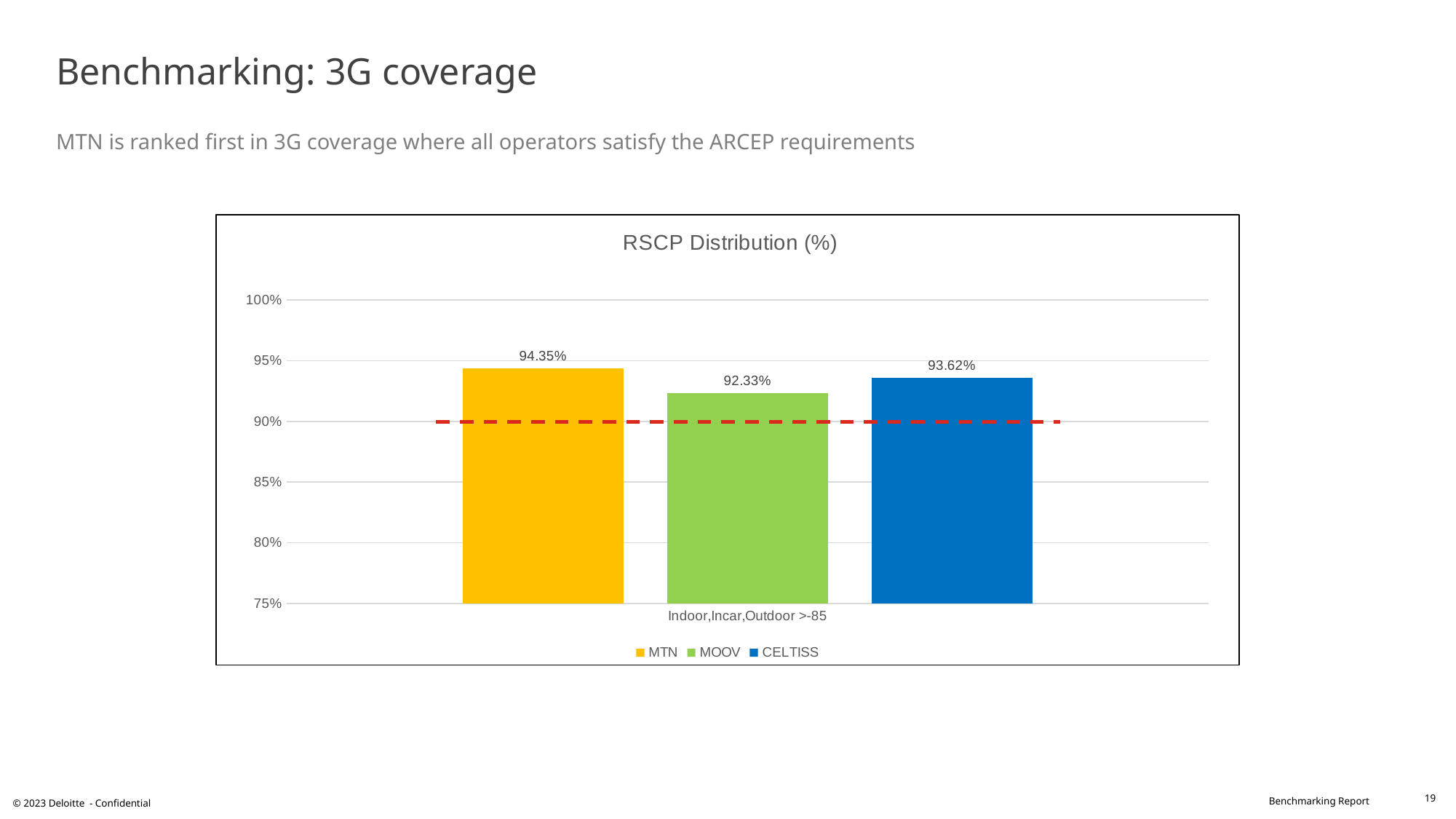
Which operator has the highest RSCP Distribution value? MTN What is the title of the chart? RSCP Distribution (%) Which operator has the lowest RSCP Distribution value? MOOV What is the value for CELTISS in the RSCP Distribution chart? 93.62% Is the value for MOOV greater or less than 90%? greater What is the difference between the MTN and MOOV values? 2.02% What is the value for MTN in the RSCP Distribution chart? 94.35% What is the value for MOOV in the RSCP Distribution chart? 92.33% How many series does the legend list? 3 What kind of chart is shown on the slide? Bar chart Which is larger, the value for MTN or the value for CELTISS? MTN What is the difference between the CELTISS and MOOV values? 1.29%